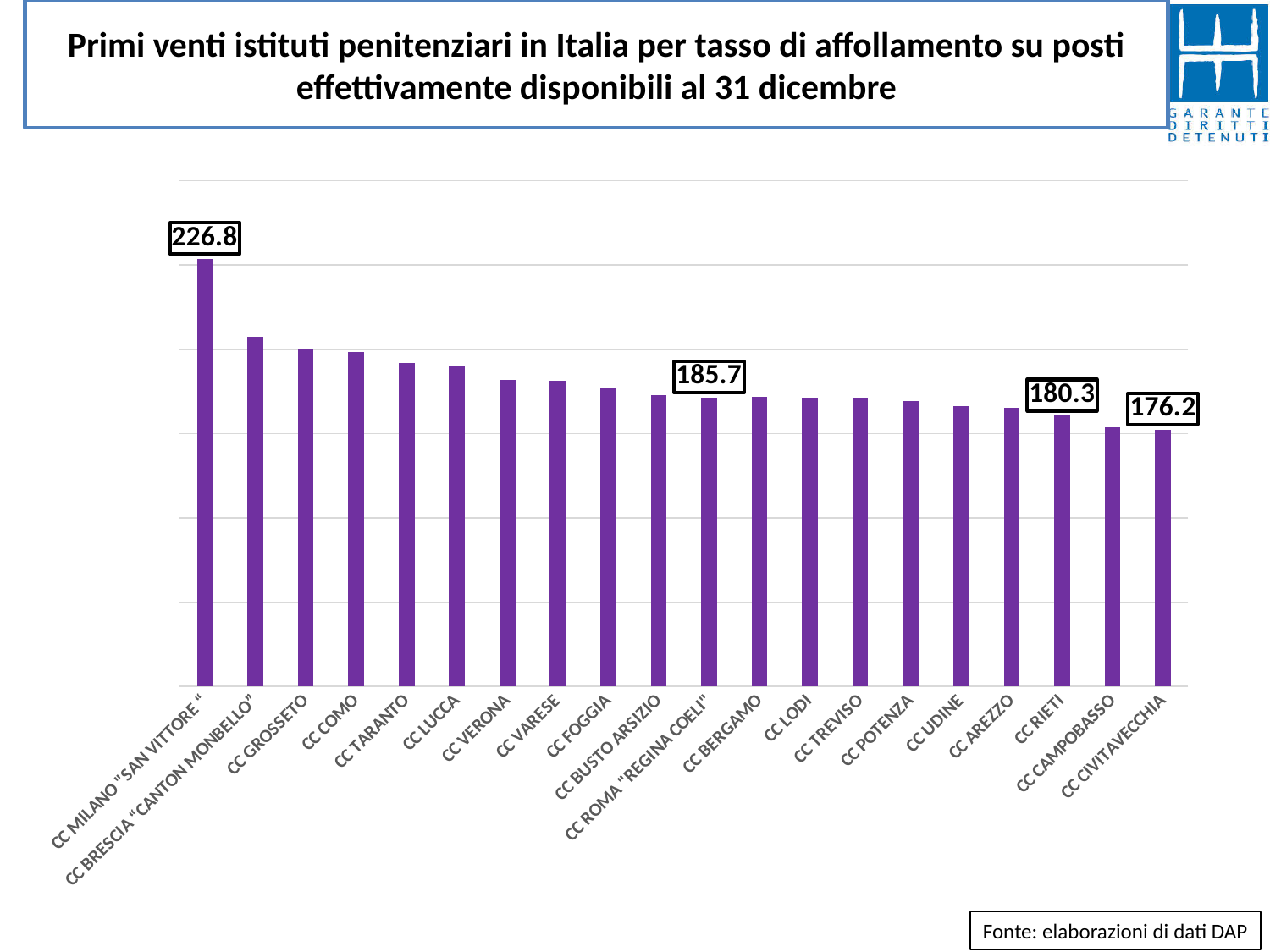
What kind of chart is shown on the slide? Bar chart What is the value for CC ROMA "REGINA COELI"? 185.7 How many institutes are shown in the chart? 20 What is the value for CC CIVITAVECCHIA? 176.2 Which has a larger value, CC GROSSETO or CC UDINE? CC GROSSETO Do the values rise or fall from left to right along the x axis? Fall Which institute has the highest value in the chart? CC MILANO "SAN VITTORE" What is the difference between the values for CC MILANO "SAN VITTORE" and CC CIVITAVECCHIA? 50.6 What is the value for CC MILANO "SAN VITTORE"? 226.8 What is the value for CC RIETI? 180.3 Which institute has the lowest value in the chart? CC CIVITAVECCHIA What is the difference between the values for CC ROMA "REGINA COELI" and CC RIETI? 5.4